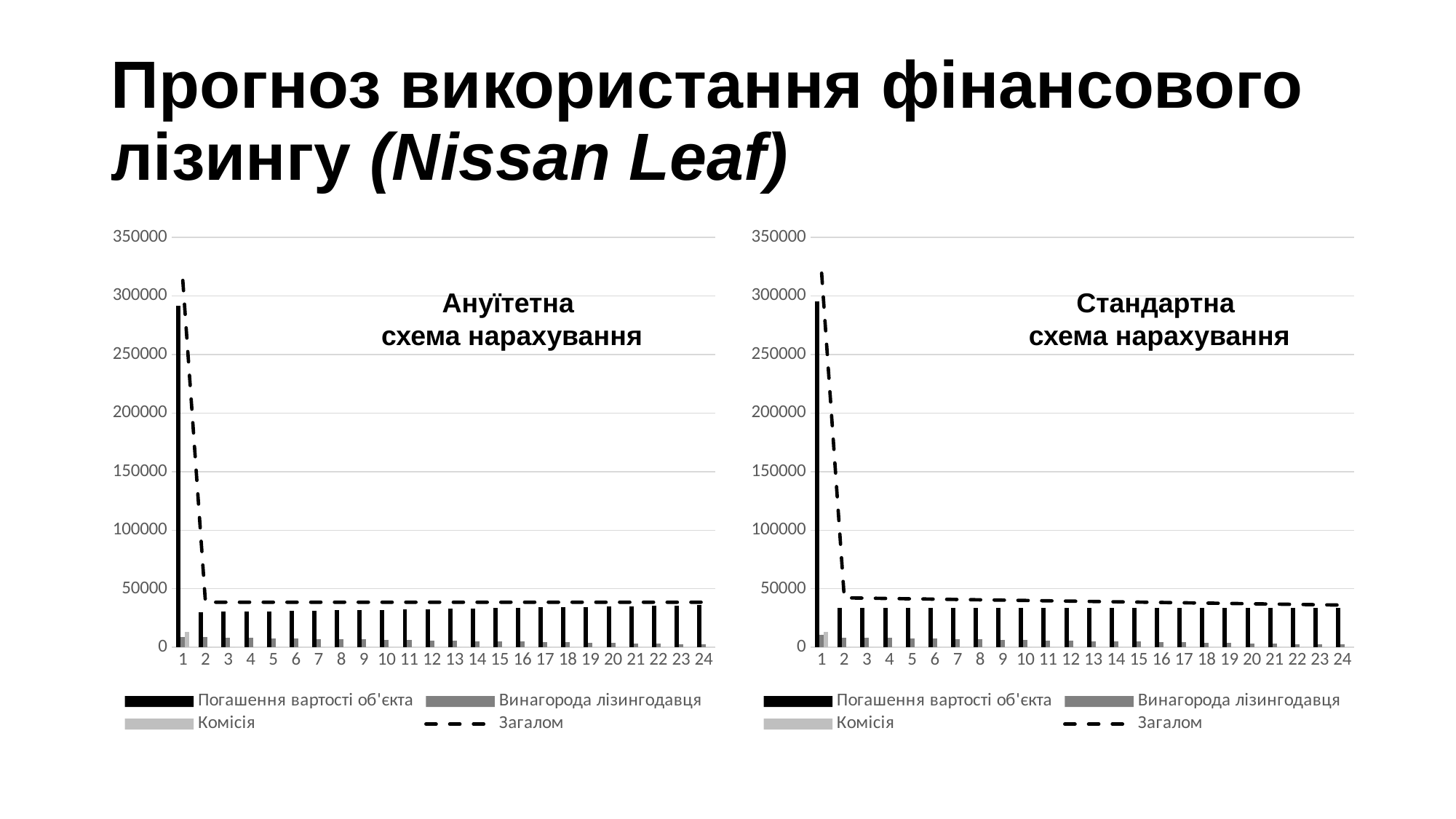
How many charts are on the slide? 2 In the chart titled 'Ануїтетна схема нарахування', which is larger: 'Погашення вартості об'єкта' for period 1 or for period 2? period 1 In the chart titled 'Стандартна схема нарахування', does the 'Загалом' line rise or fall from period 2 to period 24? fall In the chart titled 'Ануїтетна схема нарахування', is the value of 'Загалом' for period 2 greater or less than 50000? less What is the highest value shown on the vertical axis of the chart titled 'Ануїтетна схема нарахування'? 350000 In the chart titled 'Стандартна схема нарахування', is the value of 'Погашення вартості об'єкта' for period 24 greater or less than 100000? less In the chart titled 'Стандартна схема нарахування', which period has the highest value for 'Погашення вартості об'єкта'? 1 In the chart titled 'Ануїтетна схема нарахування', how many periods are shown on the x axis? 24 In the chart titled 'Стандартна схема нарахування', how many series does the legend list? 4 In the chart titled 'Стандартна схема нарахування', is the value of 'Загалом' for period 1 greater or less than 300000? greater In the chart titled 'Ануїтетна схема нарахування', which series is drawn as a dashed line? Загалом